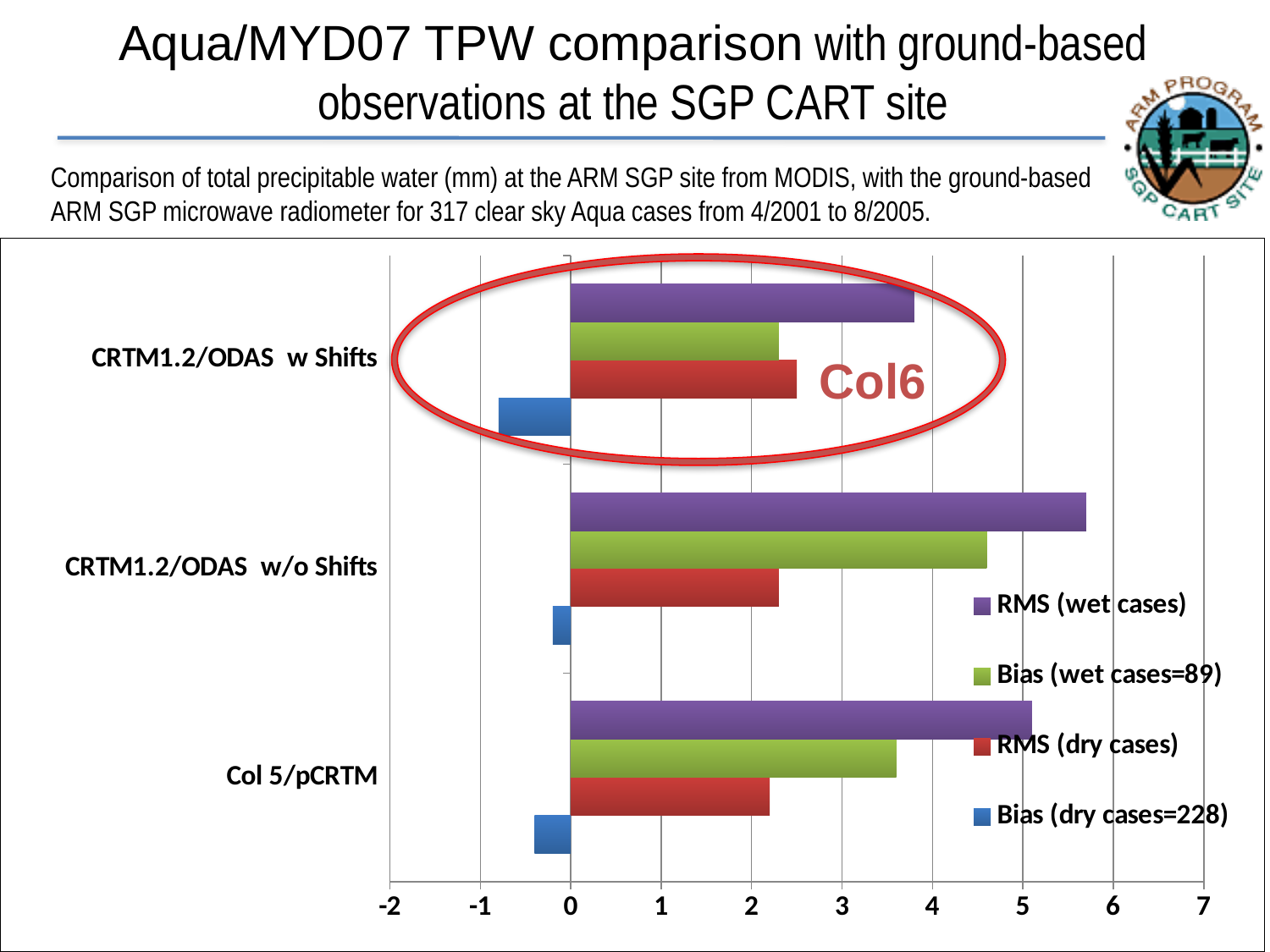
Which category has the lowest Bias (wet cases=89) value? CRTM1.2/ODAS w Shifts Is the Bias (dry cases=228) value for CRTM1.2/ODAS w Shifts greater or less than 0? less What kind of chart is shown on the slide? bar chart How many series does the legend list? 4 Which category is circled in red and labelled "Col6" on the chart? CRTM1.2/ODAS w Shifts Which category has the highest RMS (wet cases) value? CRTM1.2/ODAS w/o Shifts Which is larger for CRTM1.2/ODAS w/o Shifts: the Bias (wet cases=89) value or the RMS (dry cases) value? Bias (wet cases=89) Is the RMS (wet cases) value for CRTM1.2/ODAS w/o Shifts greater or less than 5? greater How many categories are plotted on the chart? 3 Is the Bias (wet cases=89) value for Col 5/pCRTM greater or less than 3? greater Which category has the lowest RMS (wet cases) value? CRTM1.2/ODAS w Shifts